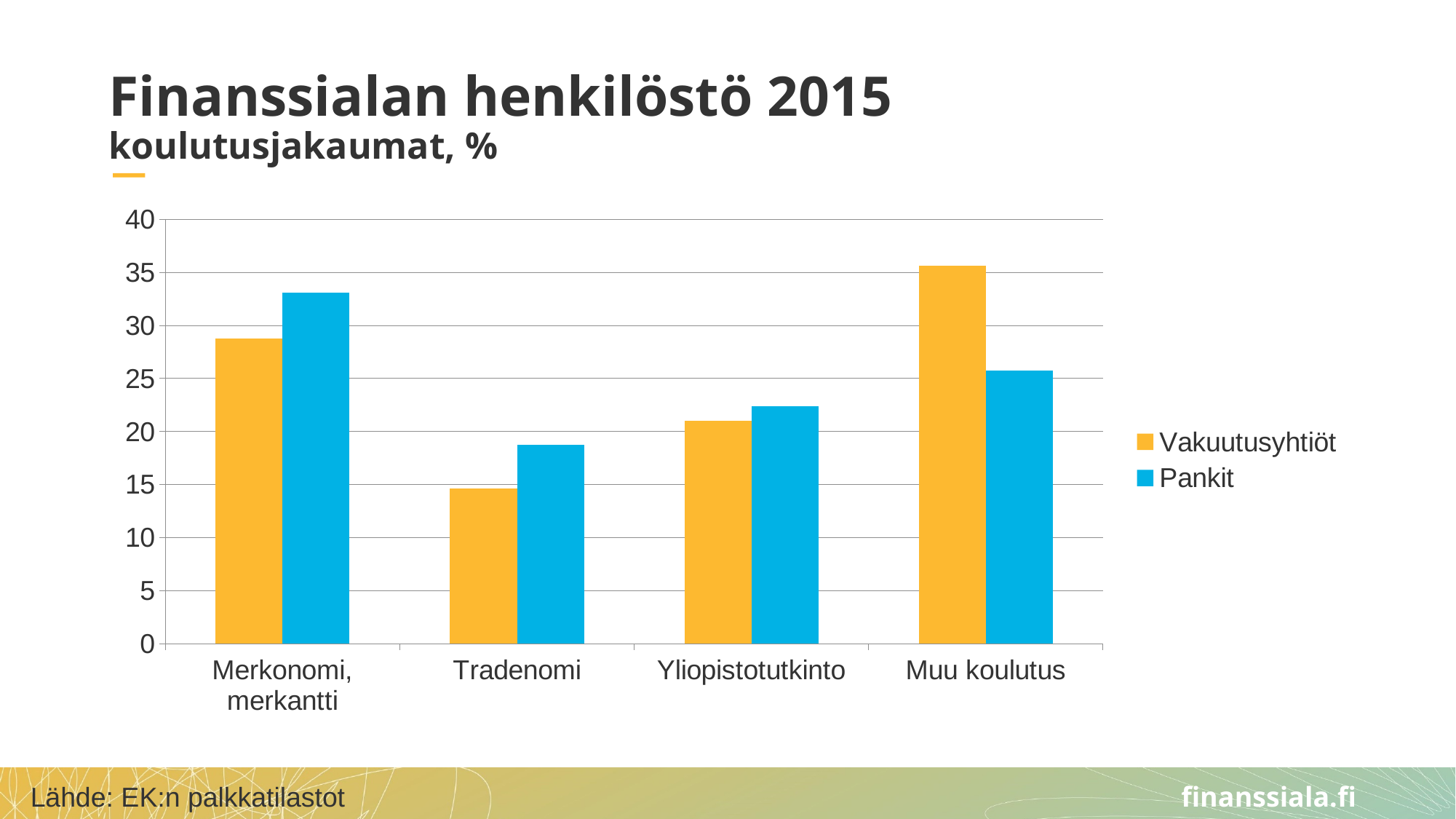
For Muu koulutus, which series has the larger value, Vakuutusyhtiöt or Pankit? Vakuutusyhtiöt Which category has the lowest value for Pankit? Tradenomi Which category has the highest value for Vakuutusyhtiöt? Muu koulutus Which category has the highest value for Pankit? Merkonomi, merkantti Which category has the lowest value for Vakuutusyhtiöt? Tradenomi What is the title of the chart on the slide? Finanssialan henkilöstö 2015 koulutusjakaumat, % What kind of chart is shown on the slide? bar chart How many series does the legend list? 2 Is the value for Pankit in Merkonomi, merkantti greater or less than 30? greater How many education categories are shown on the x axis? 4 For Merkonomi, merkantti, which series has the larger value, Vakuutusyhtiöt or Pankit? Pankit